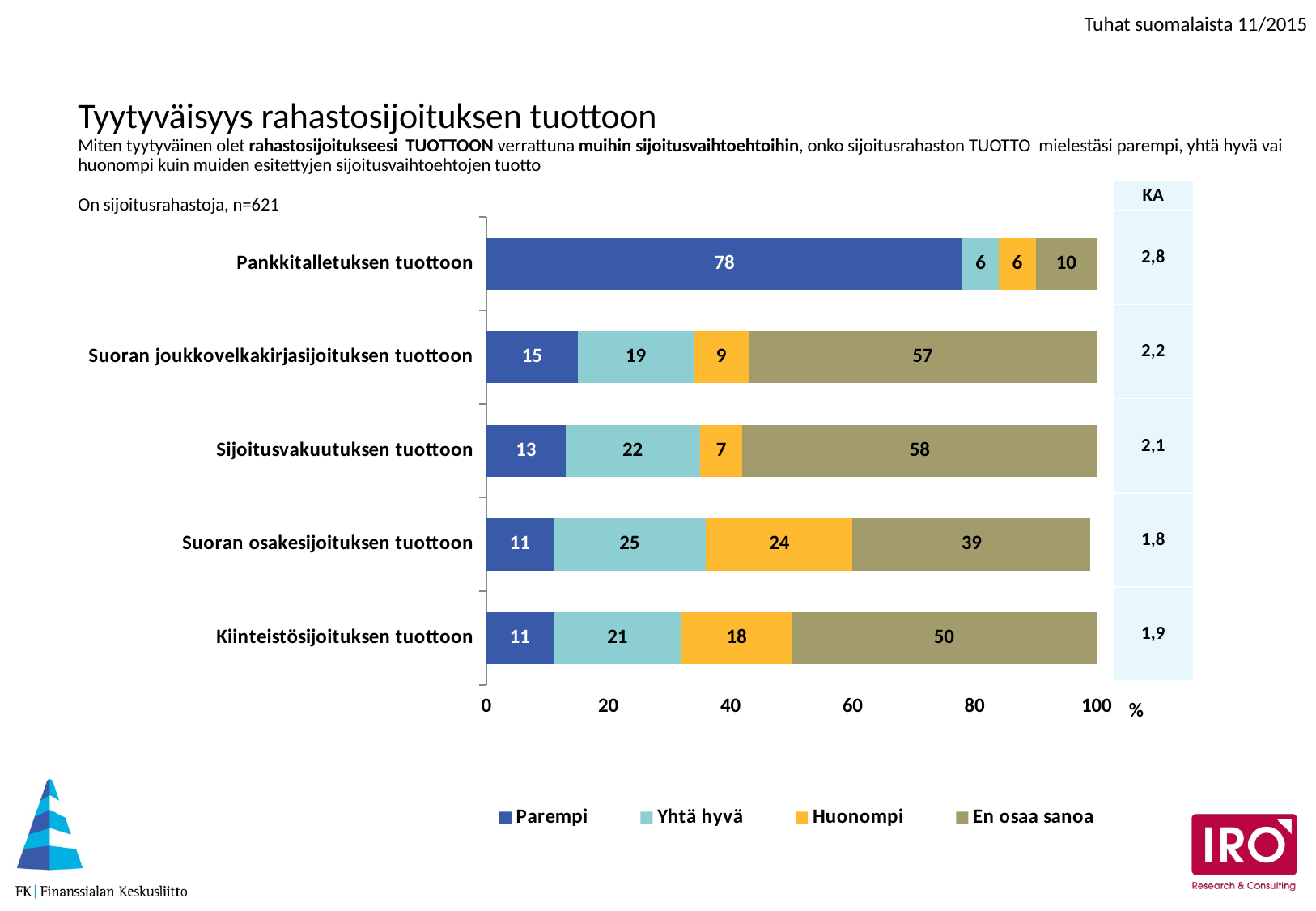
What is the 'En osaa sanoa' value for Sijoitusvakuutuksen tuottoon? 58 How many categories are shown on the chart? 5 What percentage of respondents rated fund returns as 'Parempi' compared to Pankkitalletuksen tuottoon? 78 What is the total of the stacked bar for Suoran osakesijoituksen tuottoon? 99 What is the KA value shown for Pankkitalletuksen tuottoon? 2,8 How many series does the legend list? 4 Which has a larger 'Parempi' value: Suoran joukkovelkakirjasijoituksen tuottoon or Sijoitusvakuutuksen tuottoon? Suoran joukkovelkakirjasijoituksen tuottoon Which category has the highest 'Parempi' value? Pankkitalletuksen tuottoon What kind of chart is shown on the slide? Stacked bar chart Which category has the highest 'Huonompi' value? Suoran osakesijoituksen tuottoon What is the 'Huonompi' value for Suoran osakesijoituksen tuottoon? 24 What is the difference between the 'Yhtä hyvä' values for Suoran osakesijoituksen tuottoon and Kiinteistösijoituksen tuottoon? 4